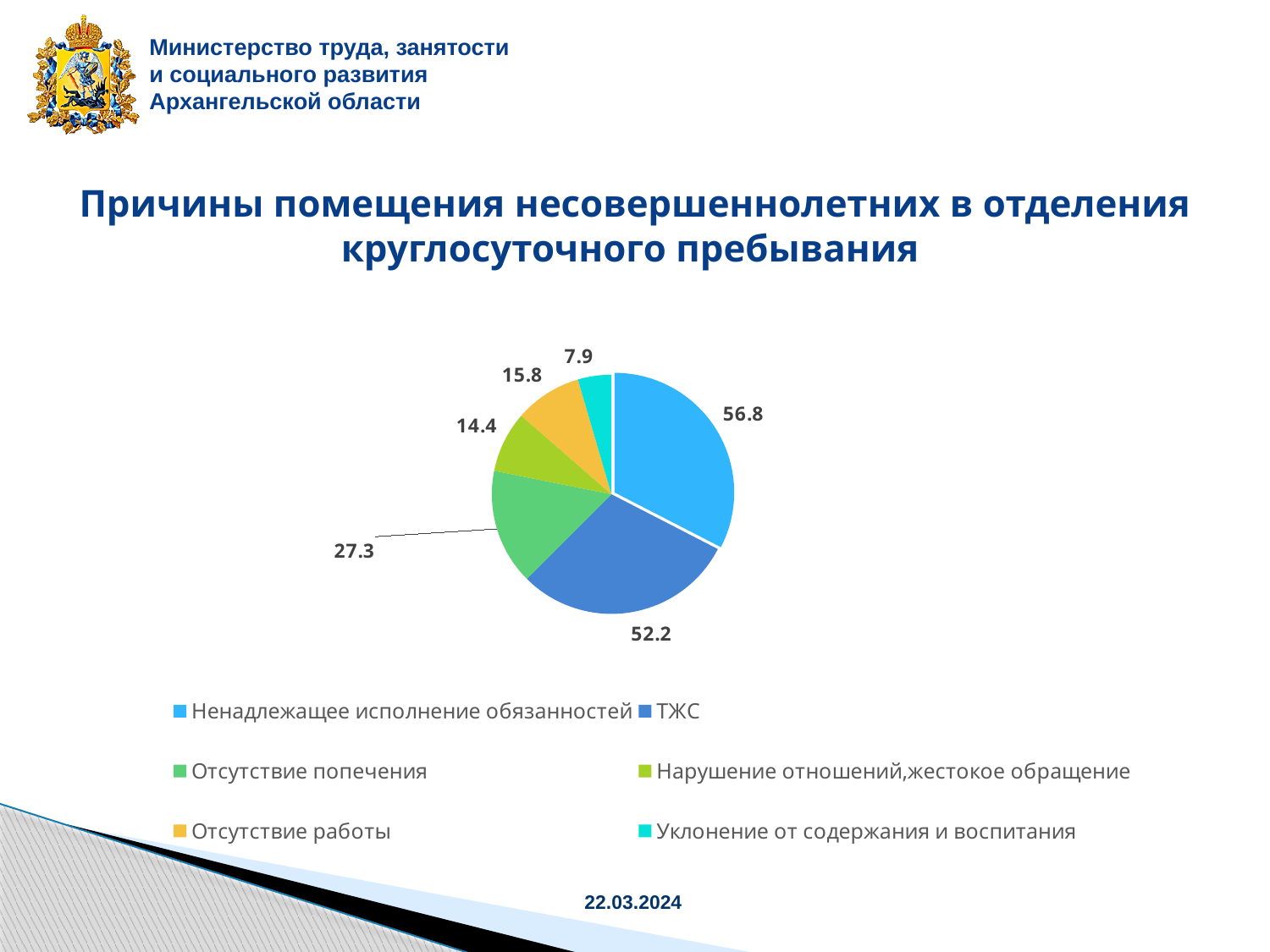
What is the value for ТЖС? 52.2 Which category has the largest slice of the pie? Ненадлежащее исполнение обязанностей What is the value for Ненадлежащее исполнение обязанностей? 56.8 What is the value for Отсутствие попечения? 27.3 What is the value for Уклонение от содержания и воспитания? 7.9 Which category has the smallest slice of the pie? Уклонение от содержания и воспитания How many slices does the pie chart have? 6 What is the title of the chart on the slide? Причины помещения несовершеннолетних в отделения круглосуточного пребывания What is the difference between the values for Ненадлежащее исполнение обязанностей and ТЖС? 4.6 What type of chart is shown on the slide? Pie chart Which is larger: the value for Отсутствие работы or the value for Нарушение отношений,жестокое обращение? Отсутствие работы How many entries does the legend list? 6